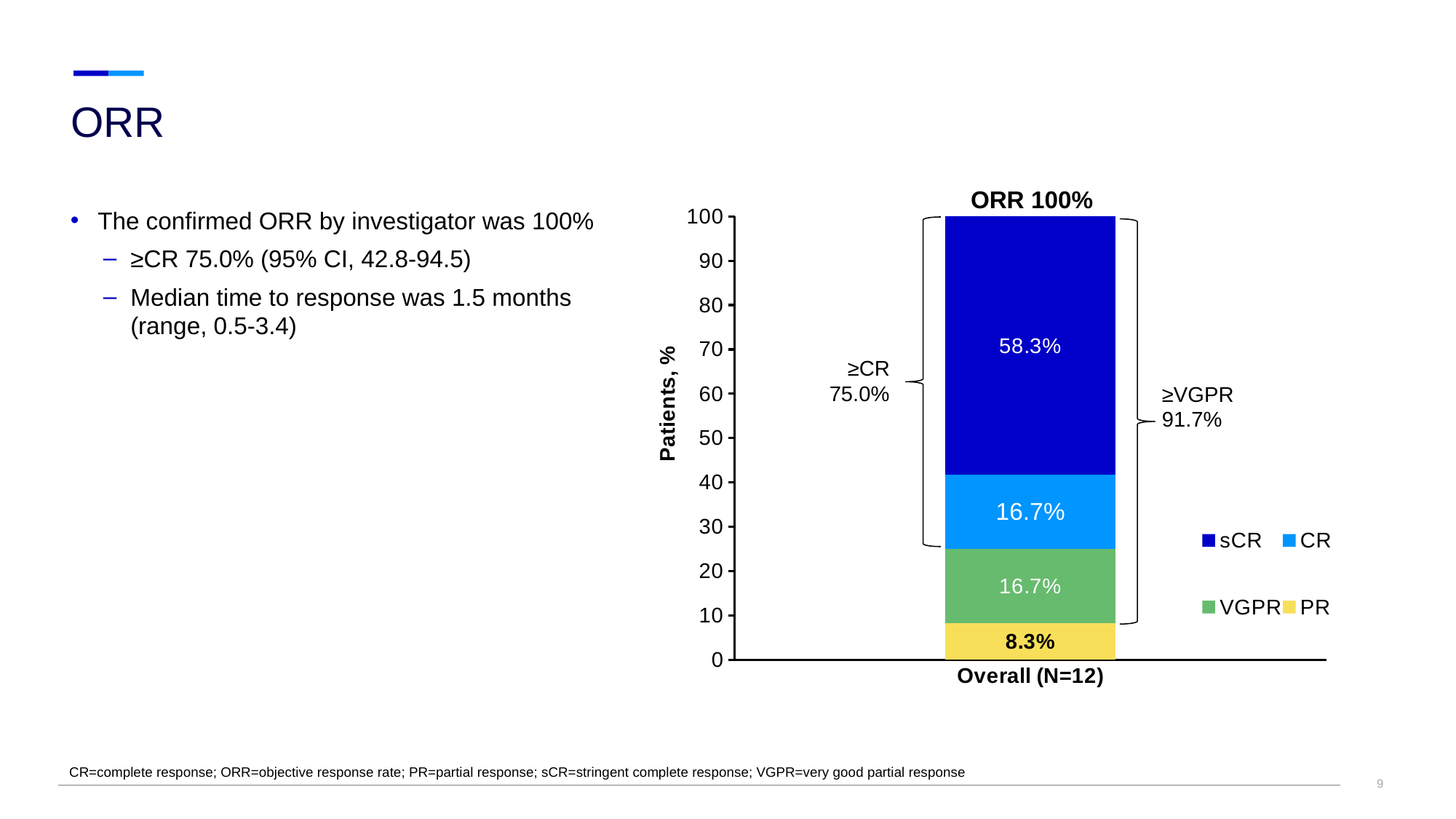
What is the value for CR in the Overall (N=12) bar? 16.7% What is the label on the y axis of the chart? Patients, % What is the value for PR in the Overall (N=12) bar? 8.3% What is the total of the stacked bar for Overall (N=12)? 100% What kind of chart is shown on the slide? Stacked bar chart Which response category has the largest segment in the stacked bar? sCR What is the value for sCR in the Overall (N=12) bar? 58.3% How many series does the legend list? 4 Which response category has the smallest segment in the stacked bar? PR What is the ≥VGPR rate annotated on the chart? 91.7% Which is larger, the sCR segment or the VGPR segment? sCR What is the difference between the sCR value and the PR value? 50.0%